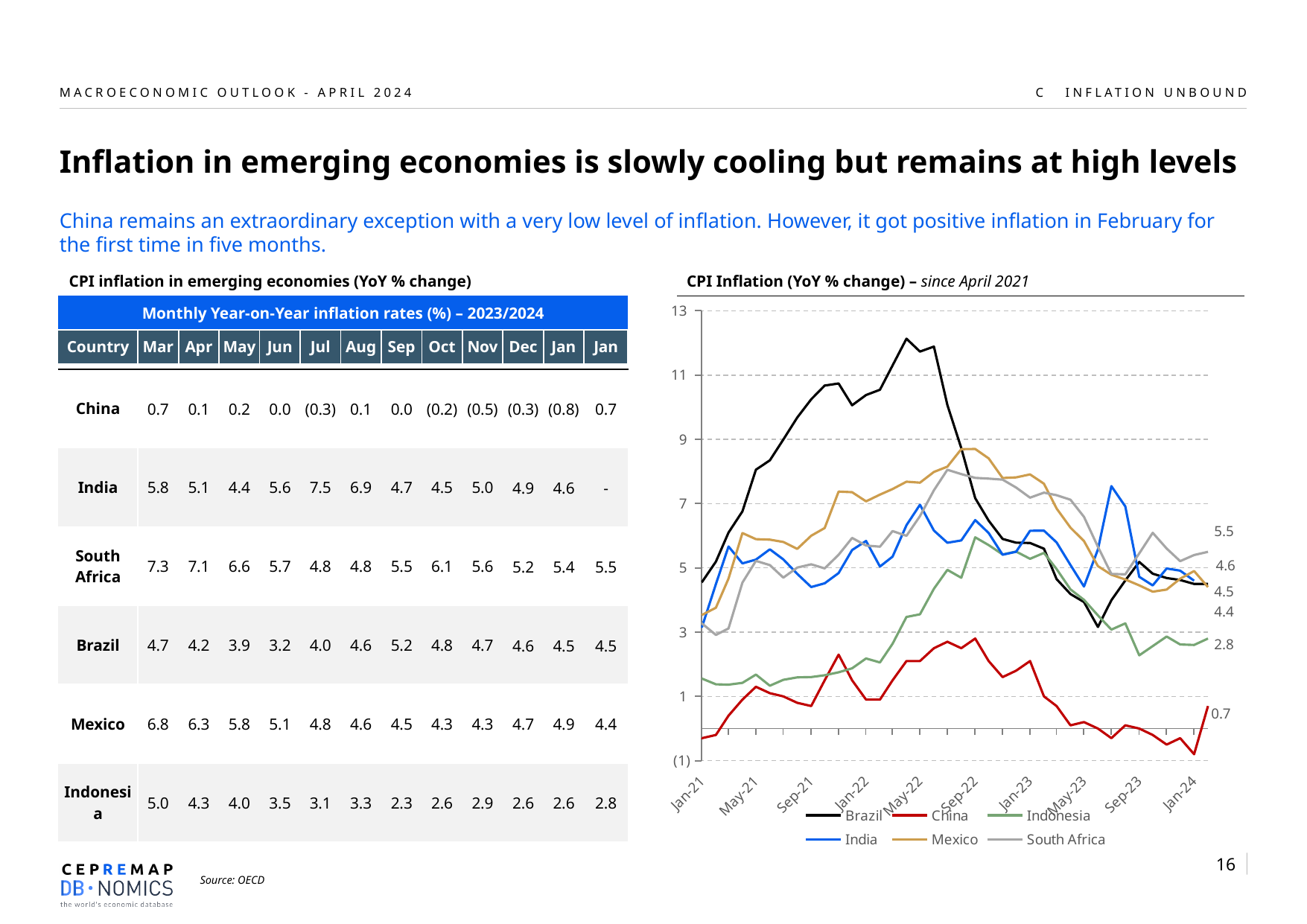
In the CPI Inflation line chart, is the highest value reached by Mexico greater or less than 7? greater In the CPI Inflation line chart, does Brazil's inflation rise or fall between Sep-22 and Jan-24? fall In the CPI Inflation line chart, what colour is the line for China? red In the CPI Inflation line chart, is the value for China at Jan-22 greater or less than 3? less In the CPI Inflation line chart, what is the latest value labelled for China? 0.7 How many series does the legend of the CPI Inflation line chart list? 6 In the CPI Inflation line chart, is the highest value reached by Brazil greater or less than 11? greater In the CPI Inflation line chart, what is the latest value labelled for Indonesia? 2.8 In the CPI Inflation line chart, which is larger at Jan-21: the value for Brazil or the value for China? Brazil In the CPI Inflation line chart, which country reaches the highest inflation value over the period? Brazil What kind of chart is the 'CPI Inflation (YoY % change) – since April 2021' chart? line chart In the CPI Inflation line chart, which country's line stays lowest over the period? China